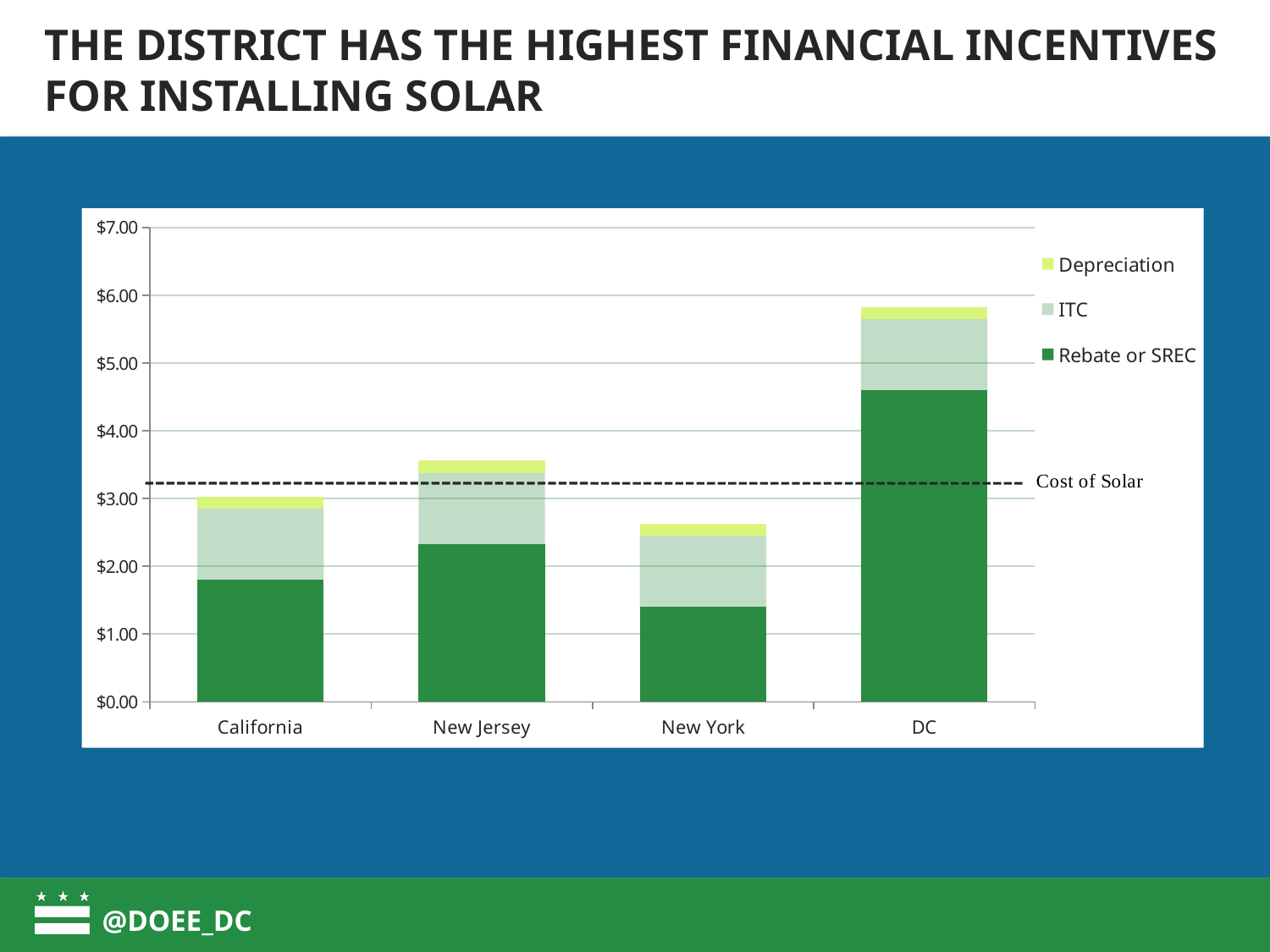
Is the Rebate or SREC value for California greater or less than $2.00? less Which series is shown in the darkest green at the bottom of each bar? Rebate or SREC Is the Rebate or SREC value for DC greater or less than $4.00? greater Which has the larger total stacked bar, New Jersey or California? New Jersey How many categories (states/jurisdictions) are shown on the x axis? 4 How many series does the legend list? 3 Which category has the lowest total stacked bar? New York Is the total stacked value for New York greater or less than $3.00? less Which category has the highest total stacked bar? DC What kind of chart is shown on the slide? Stacked bar chart What does the dashed horizontal line on the chart represent? Cost of Solar